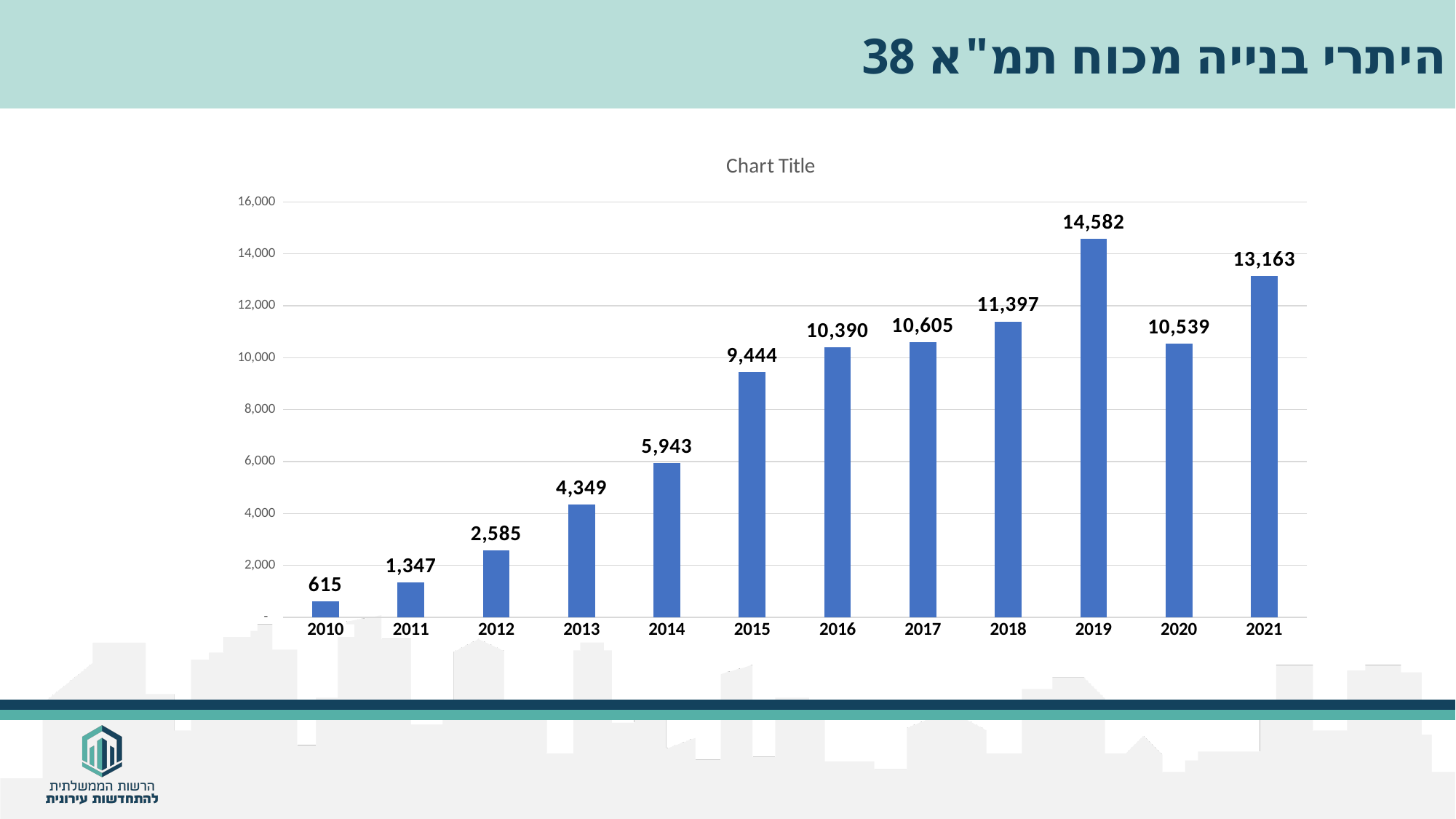
What is the value for 2010? 615 What kind of chart is shown on the slide? bar chart What is the difference between the values for 2018 and 2017? 792 What is the title printed above the chart? Chart Title Which is larger, the value for 2021 or the value for 2020? 2021 Which year has the lowest value? 2010 Is the value for 2014 greater or less than 6,000? less What is the value for 2020? 10,539 What is the difference between the values for 2019 and 2021? 1,419 Which year has the highest value? 2019 What is the value for 2019? 14,582 How many years are shown on the x axis? 12